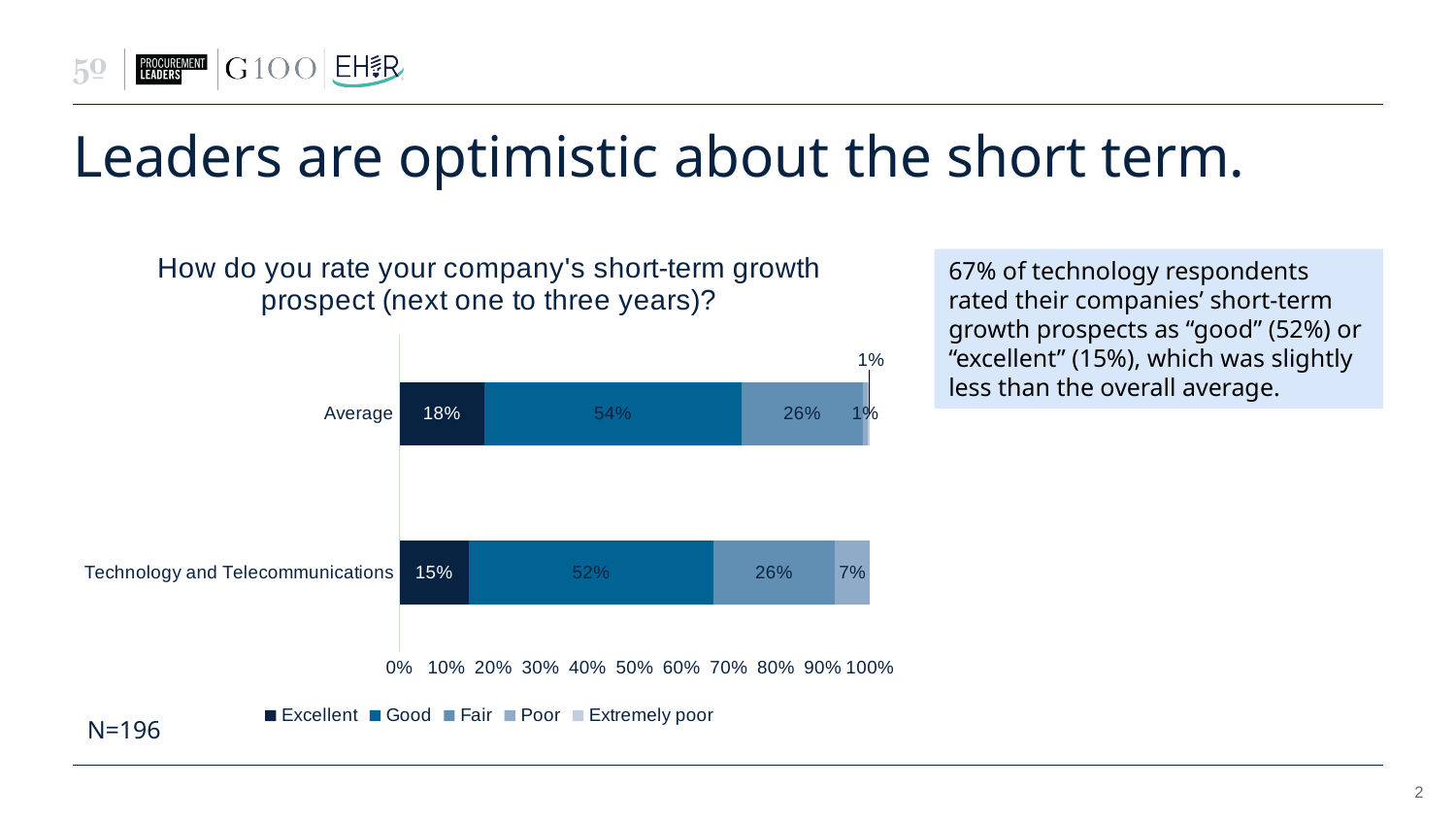
What is the Excellent value for Technology and Telecommunications? 15% What percentage of the Average bar is rated Good? 54% Which rating makes up the largest segment of the Technology and Telecommunications bar? Good What is the difference between the Good value for Average and the Good value for Technology and Telecommunications? 2 percentage points Which has the larger Poor value, Average or Technology and Telecommunications? Technology and Telecommunications What is the Fair value for the Average bar? 26% Which has the larger Excellent value, Average or Technology and Telecommunications? Average What is the Poor value for Technology and Telecommunications? 7% How many categories (bars) are plotted in the chart? 2 What is the title of the chart? How do you rate your company's short-term growth prospect (next one to three years)? What kind of chart is shown on the slide? Stacked bar chart How many series does the chart legend list? 5